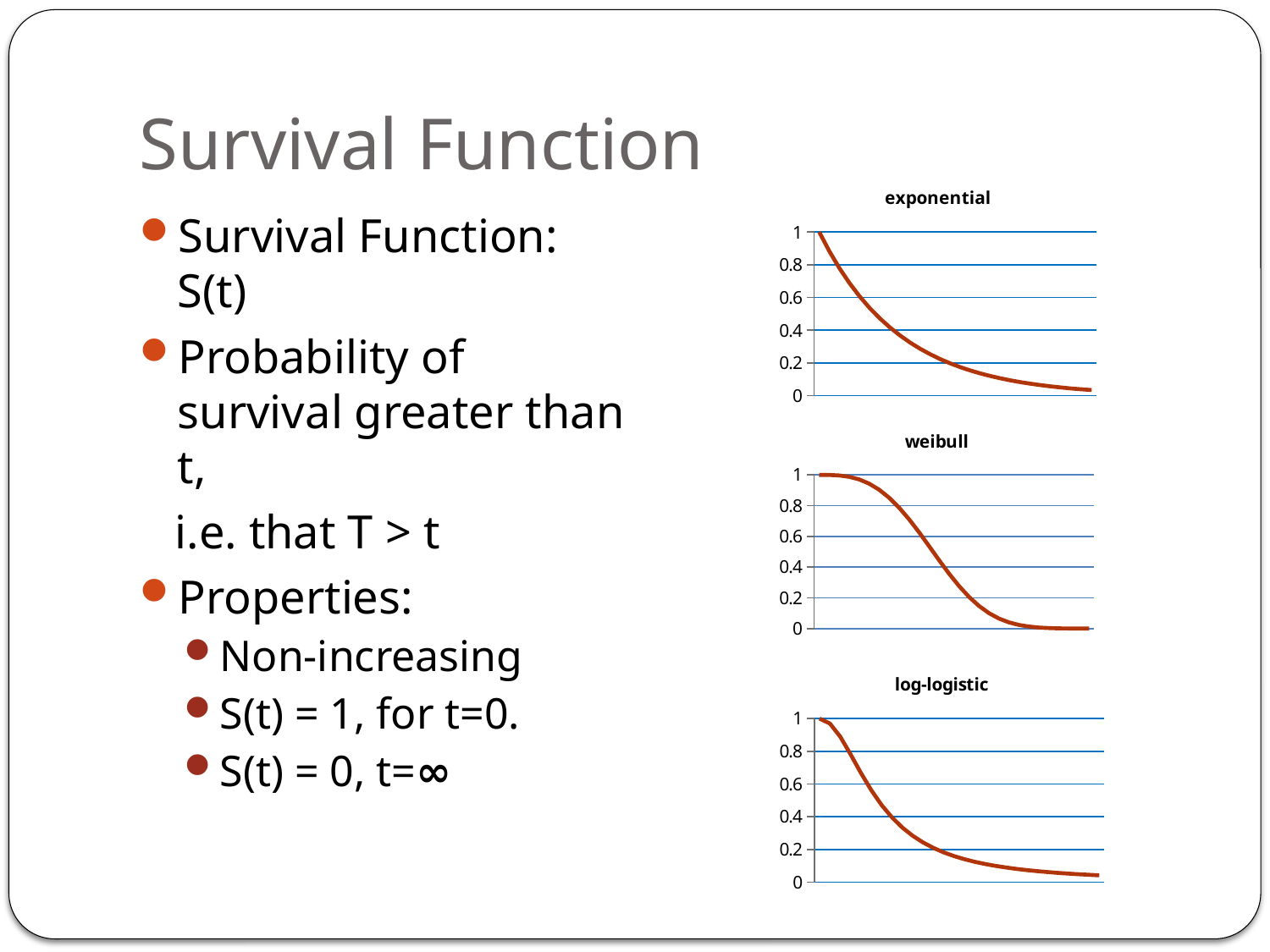
What kind of chart is the chart titled "exponential"? line chart How many charts are shown on the slide? 3 In the chart titled "exponential", do the values rise or fall along the x axis? fall In the chart titled "weibull", is the value at the right end of the curve greater or less than 0.2? less In the chart titled "weibull", is the value at the left end of the curve greater or less than 0.8? greater In the chart titled "log-logistic", do the values rise or fall along the x axis? fall What is the title of the middle chart on the slide? weibull In the chart titled "weibull", do the values rise or fall along the x axis? fall In the chart titled "exponential", is the value at the right end of the curve greater or less than 0.2? less What is the highest value shown on the y axis of the chart titled "weibull"? 1